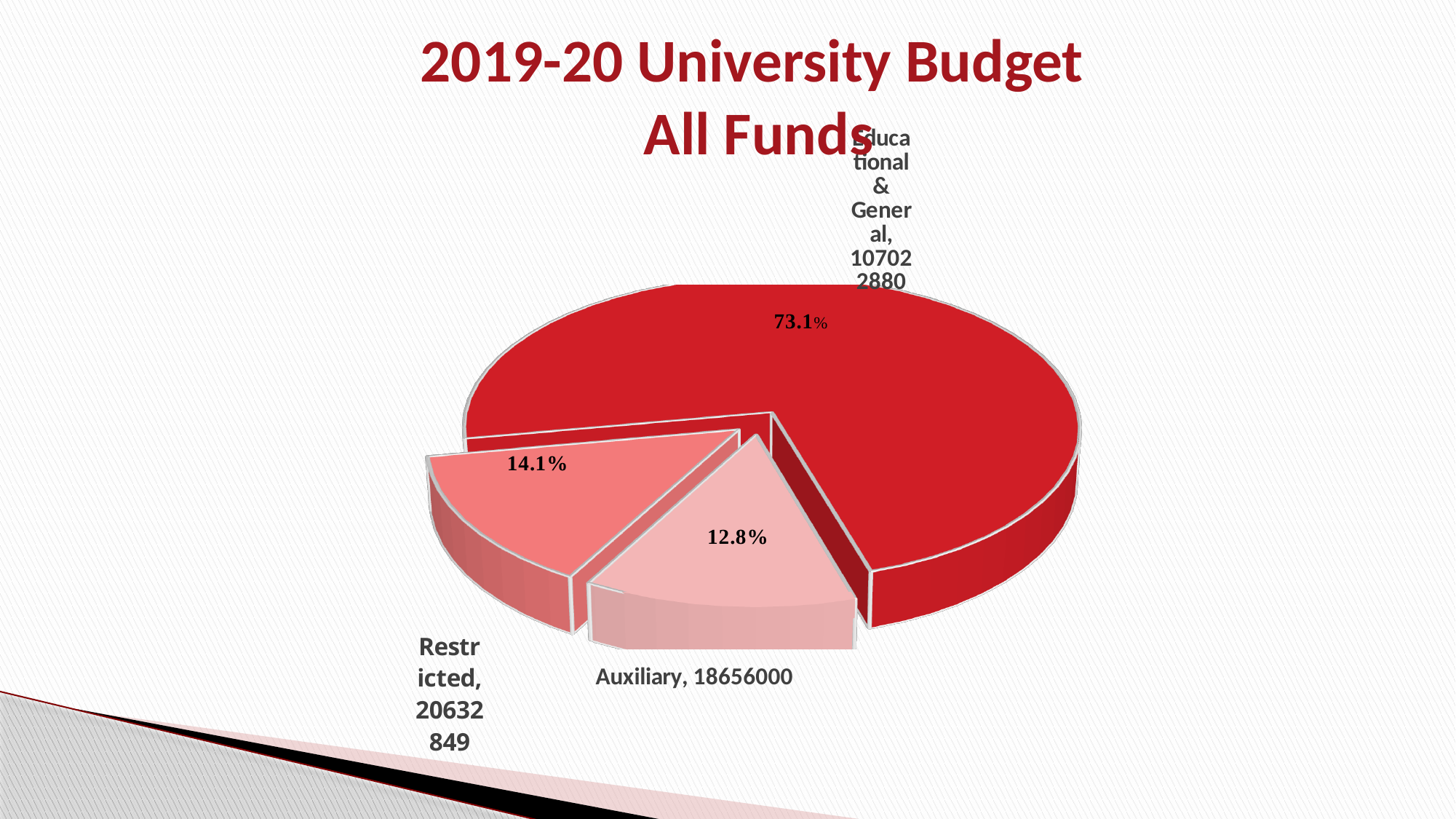
What share of the pie does Restricted represent? 14.1% What share of the pie does Auxiliary represent? 12.8% What is the value for Auxiliary? 18656000 Which category has the smallest slice? Auxiliary What is the value for Educational & General? 107022880 What kind of chart is shown on the slide? pie chart Which category has the largest slice? Educational & General Which is larger, Restricted or Auxiliary? Restricted What is the value for Restricted? 20632849 What is the title of the chart? 2019-20 University Budget All Funds How many slices does the pie chart have? 3 What share of the pie does Educational & General represent? 73.1%